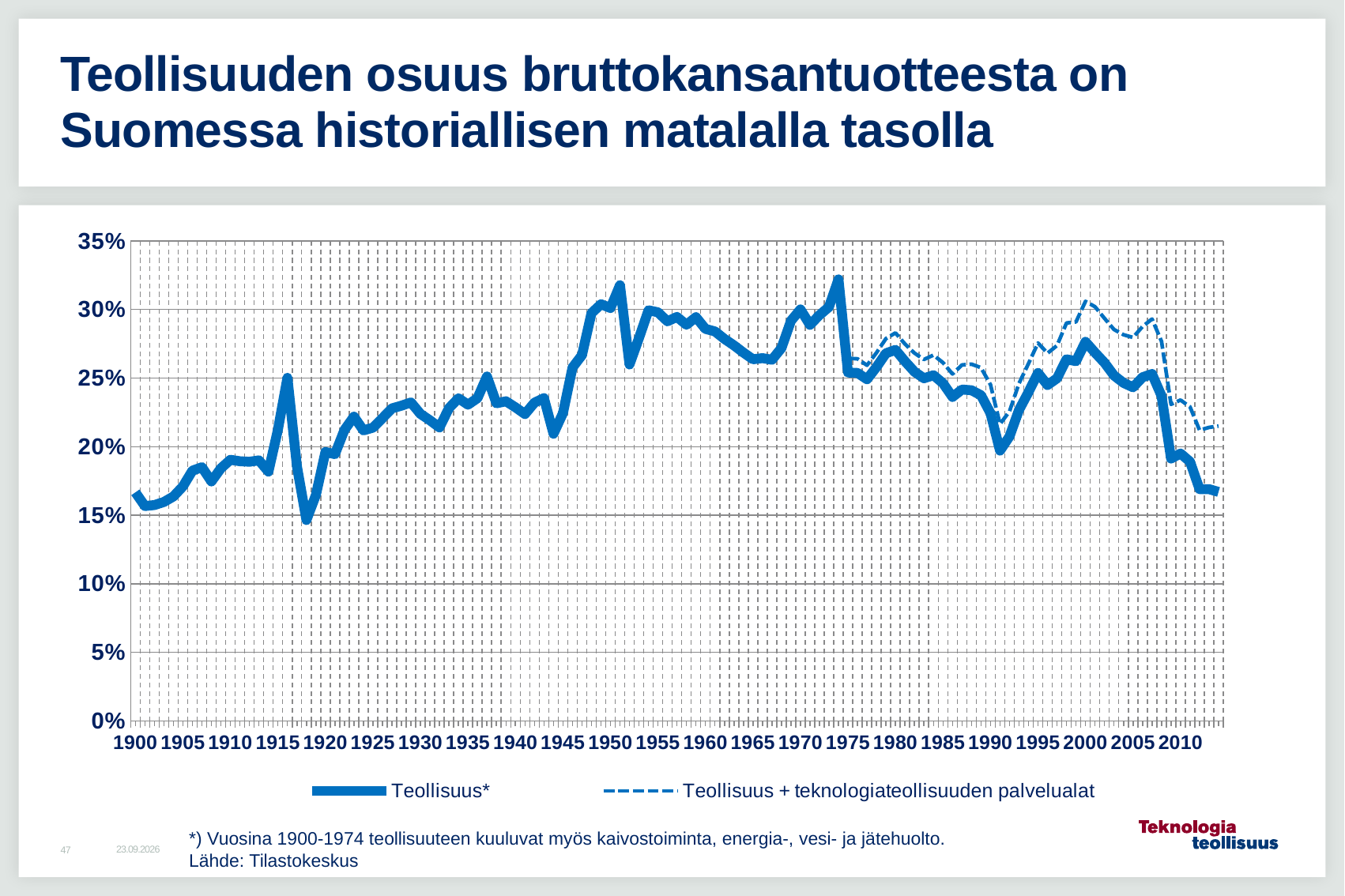
Around which year does the Teollisuus* series reach its lowest value? 1918 How many series does the legend list? 2 What is the label of the dashed line series in the legend? Teollisuus + teknologiateollisuuden palvelualat Does the Teollisuus* series rise or fall between 2007 and 2013? fall Is the value of Teollisuus* in 1900 greater or less than 20%? less Is the value of Teollisuus* in 1974 greater or less than 30%? greater Is the value of Teollisuus + teknologiateollisuuden palvelualat in 2000 greater or less than 25%? greater What is the label of the solid line series in the legend? Teollisuus* In 2010, which series has the higher value: Teollisuus* or Teollisuus + teknologiateollisuuden palvelualat? Teollisuus + teknologiateollisuuden palvelualat What kind of chart is shown on the slide? line chart Does the Teollisuus* series rise or fall between 1900 and 1916? rise